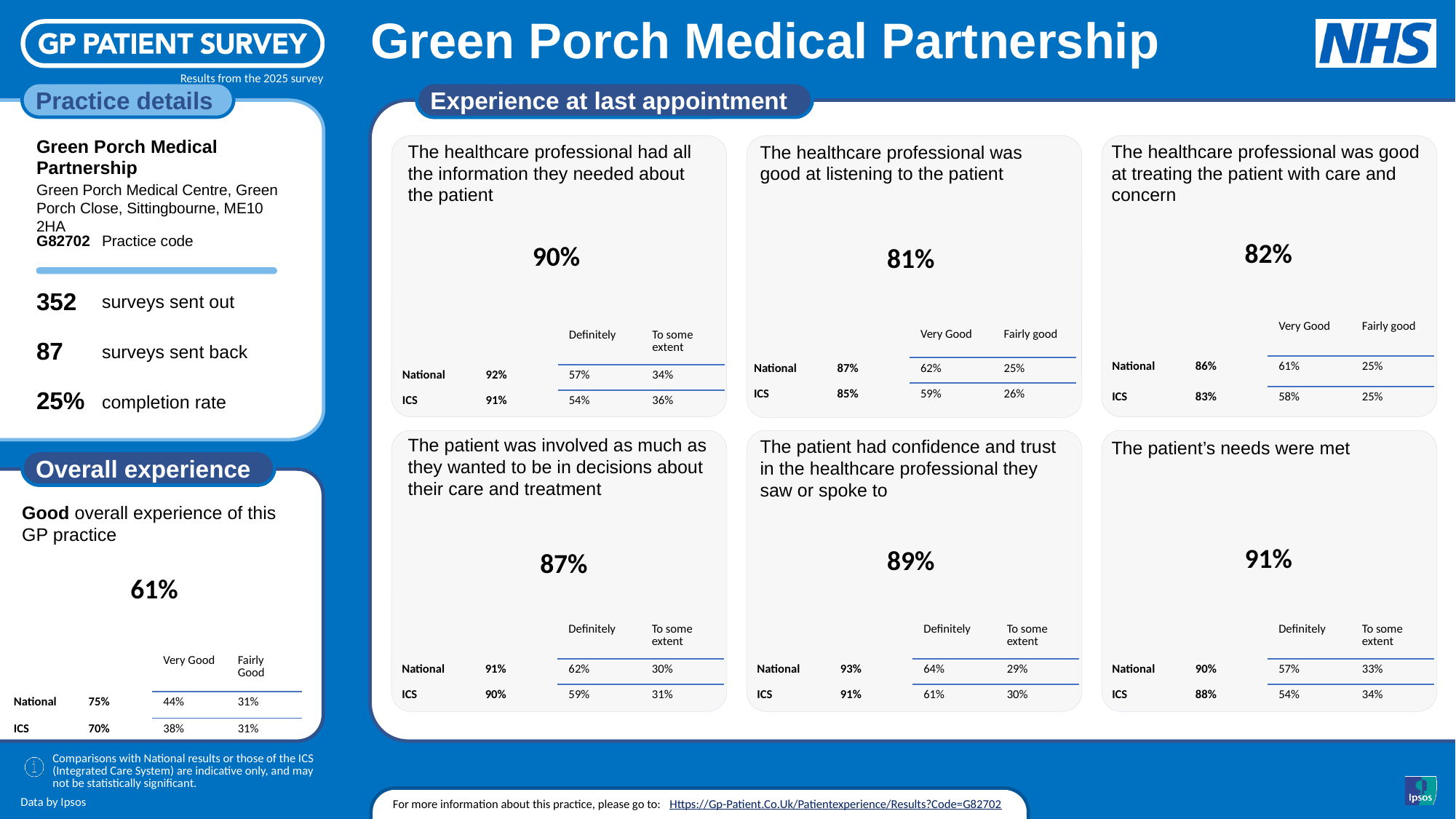
In the 'Experience at last appointment' section, what is the ICS percentage for 'The healthcare professional was good at treating the patient with care and concern'? 83% In the 'Experience at last appointment' section, which of the six statements has the lowest practice percentage? The healthcare professional was good at listening to the patient In the 'Experience at last appointment' section, what percentage is shown for 'The patient's needs were met'? 91% In the 'Experience at last appointment' section, what percentage is shown for 'The healthcare professional was good at listening to the patient'? 81% In the 'Experience at last appointment' section, what is the difference between the practice percentage for 'The patient's needs were met' and for 'The healthcare professional was good at listening to the patient'? 10 percentage points In the 'Experience at last appointment' section, which is higher: the practice percentage for 'The patient had confidence and trust in the healthcare professional they saw or spoke to' or for 'The patient was involved as much as they wanted to be in decisions about their care and treatment'? The patient had confidence and trust in the healthcare professional they saw or spoke to How many statements are shown in the 'Experience at last appointment' section? 6 In the 'Overall experience' section, what is the difference between the National percentage (75%) and the practice percentage (61%) for good overall experience? 14 percentage points In the 'Overall experience' section, what percentage of patients reported a good overall experience of this GP practice? 61% In the 'Experience at last appointment' section, what percentage is shown for 'The healthcare professional had all the information they needed about the patient'? 90% In the 'Overall experience' section, what is the National percentage for good overall experience? 75% In the 'Experience at last appointment' section, which of the six statements has the highest practice percentage? The patient's needs were met